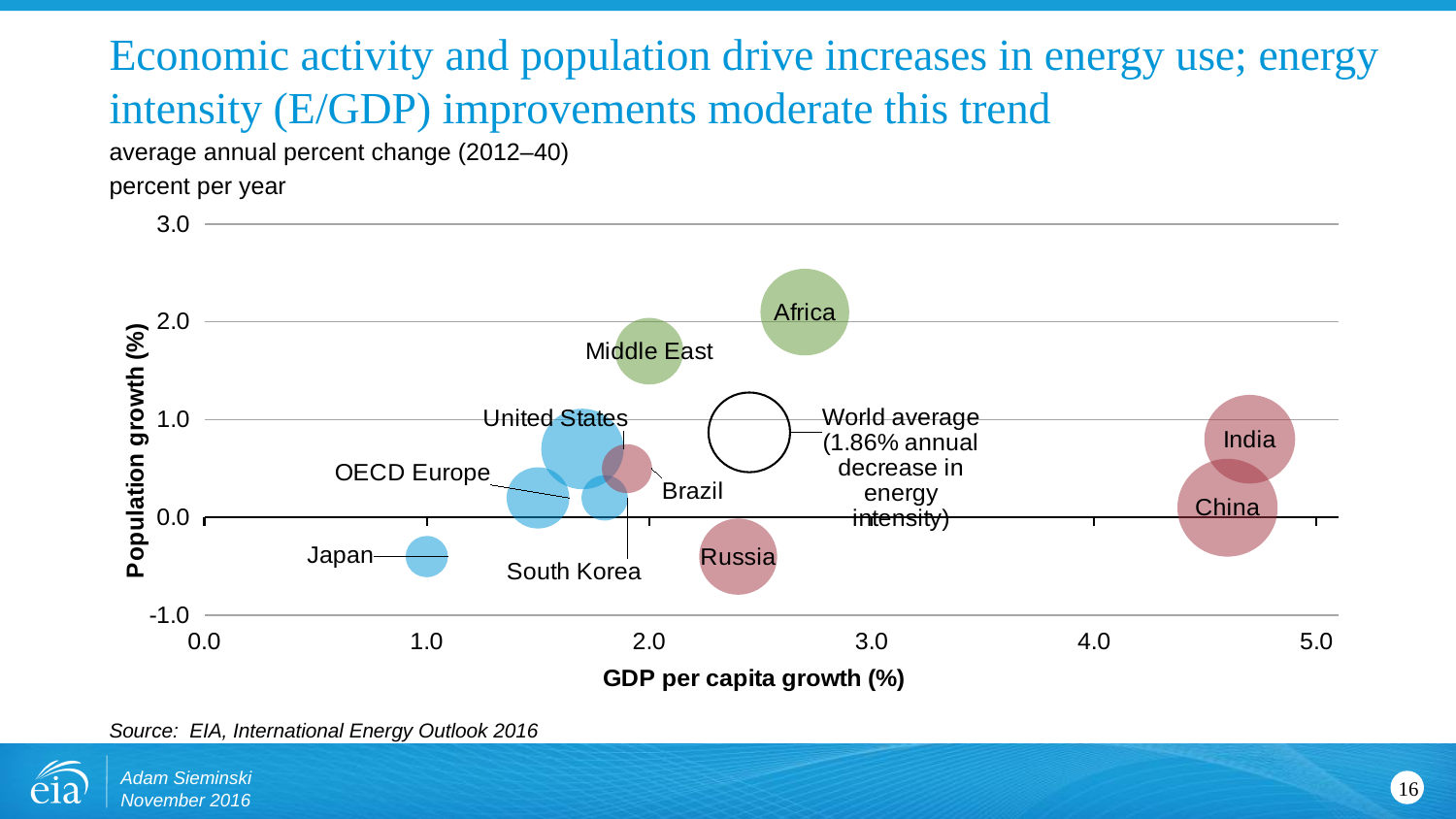
What is the world average annual decrease in energy intensity stated on the chart? 1.86% Which has higher population growth, Middle East or Brazil? Middle East Which country or region has the lowest GDP per capita growth on the chart? Japan How many labeled countries or regions (excluding the world average) are plotted on the chart? 10 Which has higher GDP per capita growth, India or United States? India Which country or region has the highest population growth on the chart? Africa Is the population growth for Japan greater or less than 0.0? less Is the population growth for Middle East greater or less than 1.0? greater What kind of chart is shown on the slide? bubble chart Is the GDP per capita growth for Africa greater or less than 2.0? greater What is the label of the horizontal axis of the chart? GDP per capita growth (%)